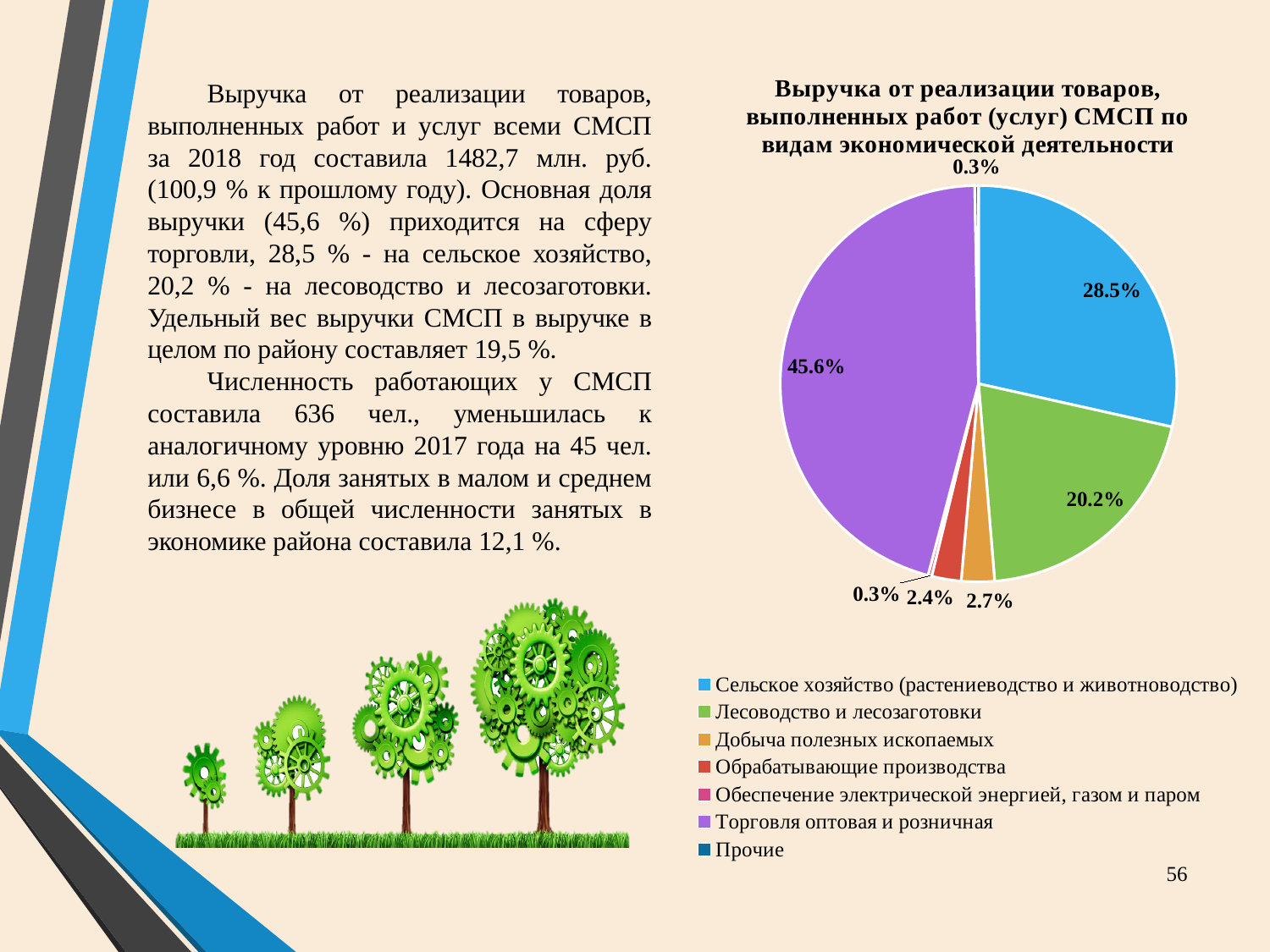
What is the combined share of "Сельское хозяйство (растениеводство и животноводство)" and "Лесоводство и лесозаготовки"? 48.7% What share of revenue does "Добыча полезных ископаемых" account for? 2.7% What type of chart is shown on the slide? pie chart Which has a larger share: "Лесоводство и лесозаготовки" or "Добыча полезных ископаемых"? Лесоводство и лесозаготовки Which category has the largest share of the pie? Торговля оптовая и розничная What share of revenue does "Сельское хозяйство (растениеводство и животноводство)" account for? 28.5% How many categories does the legend list? 7 What share of revenue does "Торговля оптовая и розничная" account for in the pie chart? 45.6% What colour is the slice for "Торговля оптовая и розничная"? purple What share of revenue does "Лесоводство и лесозаготовки" account for? 20.2% What share of revenue does "Обрабатывающие производства" account for? 2.4% What is the difference in share between "Торговля оптовая и розничная" and "Сельское хозяйство (растениеводство и животноводство)"? 17.1%